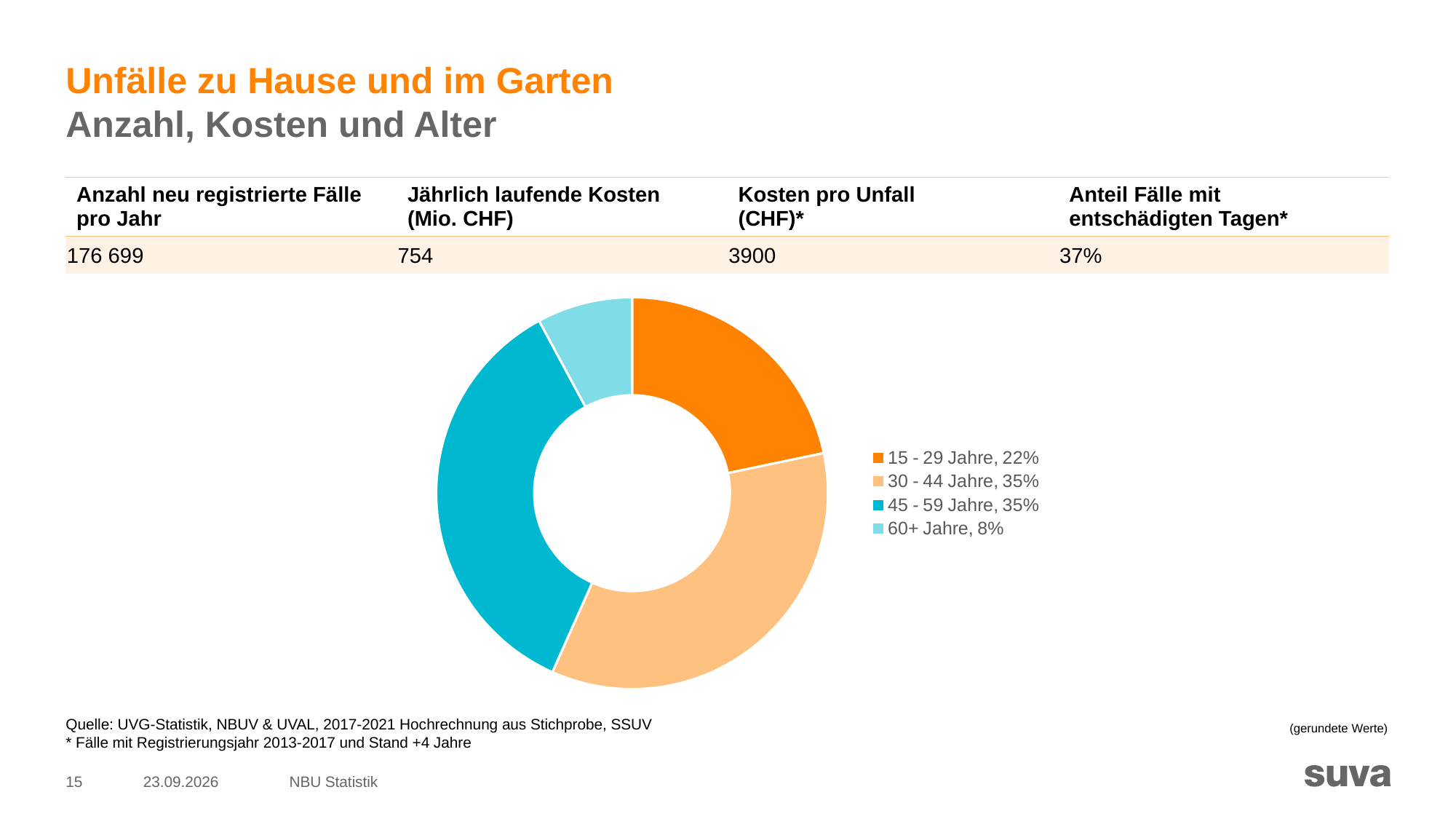
What share of the donut chart is the 30 - 44 Jahre slice? 35% What share of the donut chart is the 60+ Jahre slice? 8% How many age groups (slices) does the donut chart show? 4 Which two age groups have the same share in the donut chart? 30 - 44 Jahre and 45 - 59 Jahre Which slice is larger: 15 - 29 Jahre or 60+ Jahre? 15 - 29 Jahre What colour is the 45 - 59 Jahre slice in the donut chart? Teal (dark cyan) What is the difference in percentage points between the 15 - 29 Jahre slice and the 60+ Jahre slice? 14 percentage points What is the difference in percentage points between the 30 - 44 Jahre slice and the 15 - 29 Jahre slice? 13 percentage points What share of the donut chart is the 15 - 29 Jahre slice? 22% Which age group has the smallest slice in the donut chart? 60+ Jahre What kind of chart is shown on the slide? Donut (pie) chart